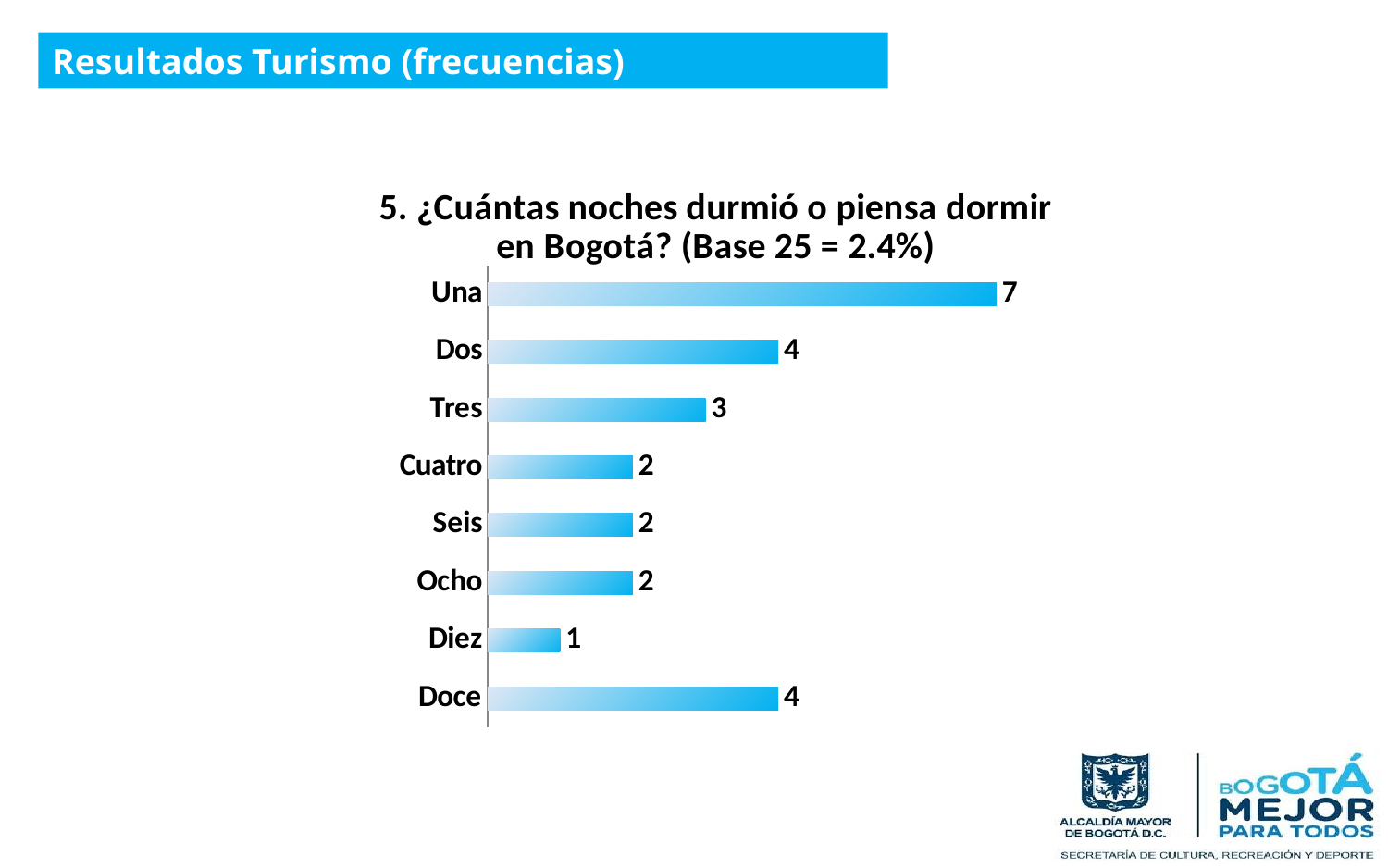
What is the difference between the values for "Una" and "Dos"? 3 What kind of chart is shown on the slide? Bar chart Which is larger, the value for "Tres" or the value for "Doce"? Doce What is the value for "Una"? 7 What is the value for "Tres"? 3 How many categories are shown in the chart? 8 Which category has the highest value? Una What is the total of the values for "Cuatro", "Seis" and "Ocho"? 6 What is the value for "Doce"? 4 What is the value for "Diez"? 1 What base is stated in the chart title? Base 25 = 2.4% Which category has the lowest value? Diez